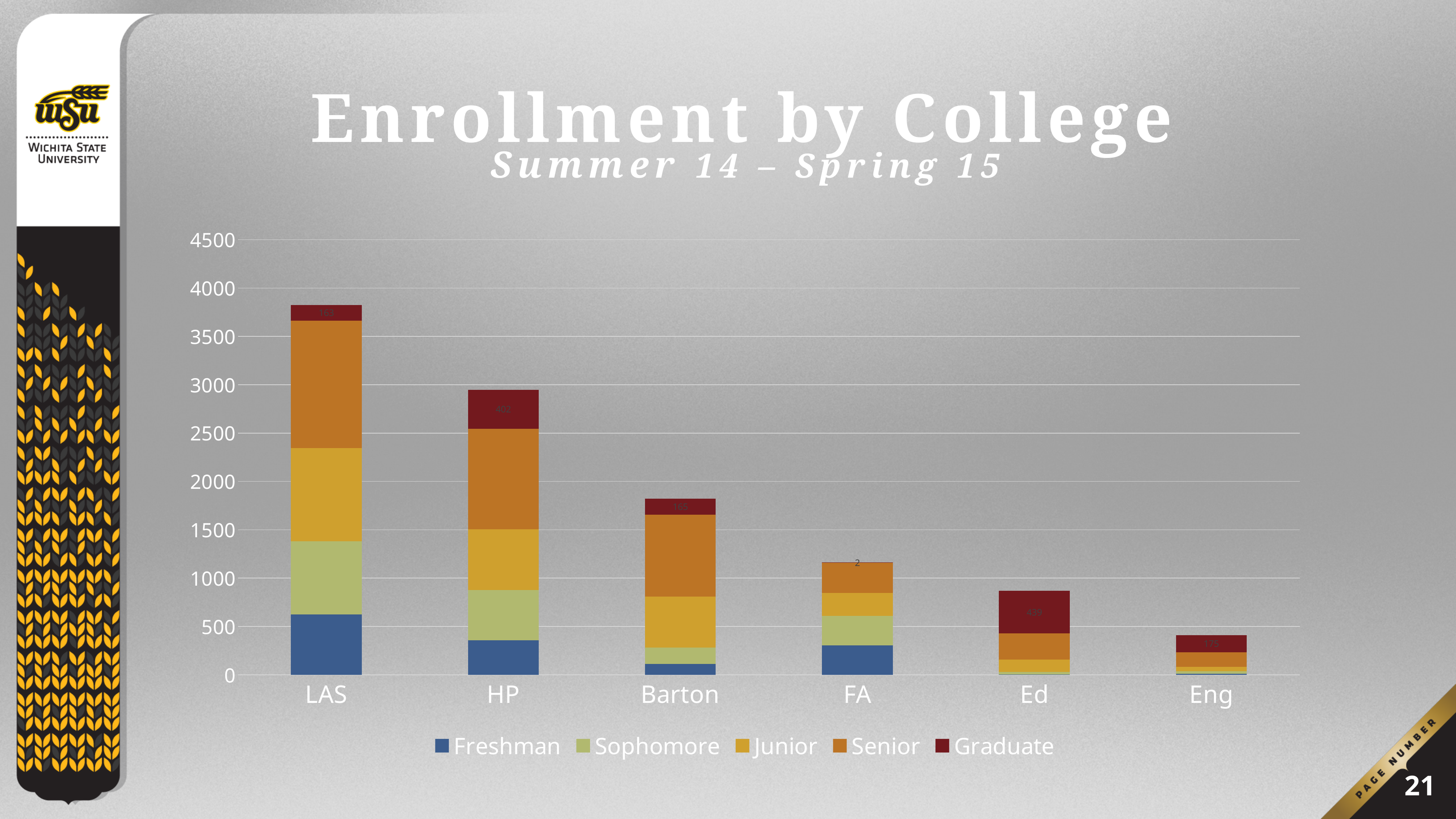
Which college has the lowest total enrollment in the chart? Eng What is the difference between the Graduate values for Ed and HP? 37 Is the total enrollment for LAS greater or less than 3500? greater What kind of chart is shown on the slide? Stacked bar chart How many colleges are shown on the x axis of the chart? 6 Which college has the highest total enrollment in the chart? LAS Do the total bar heights rise or fall from LAS to Eng along the x axis? Fall What is the Graduate value for HP? 402 What is the Graduate value for LAS? 163 Which has the larger Graduate value, HP or Ed? Ed How many series does the chart's legend list? 5 What is the Graduate value for Ed? 439